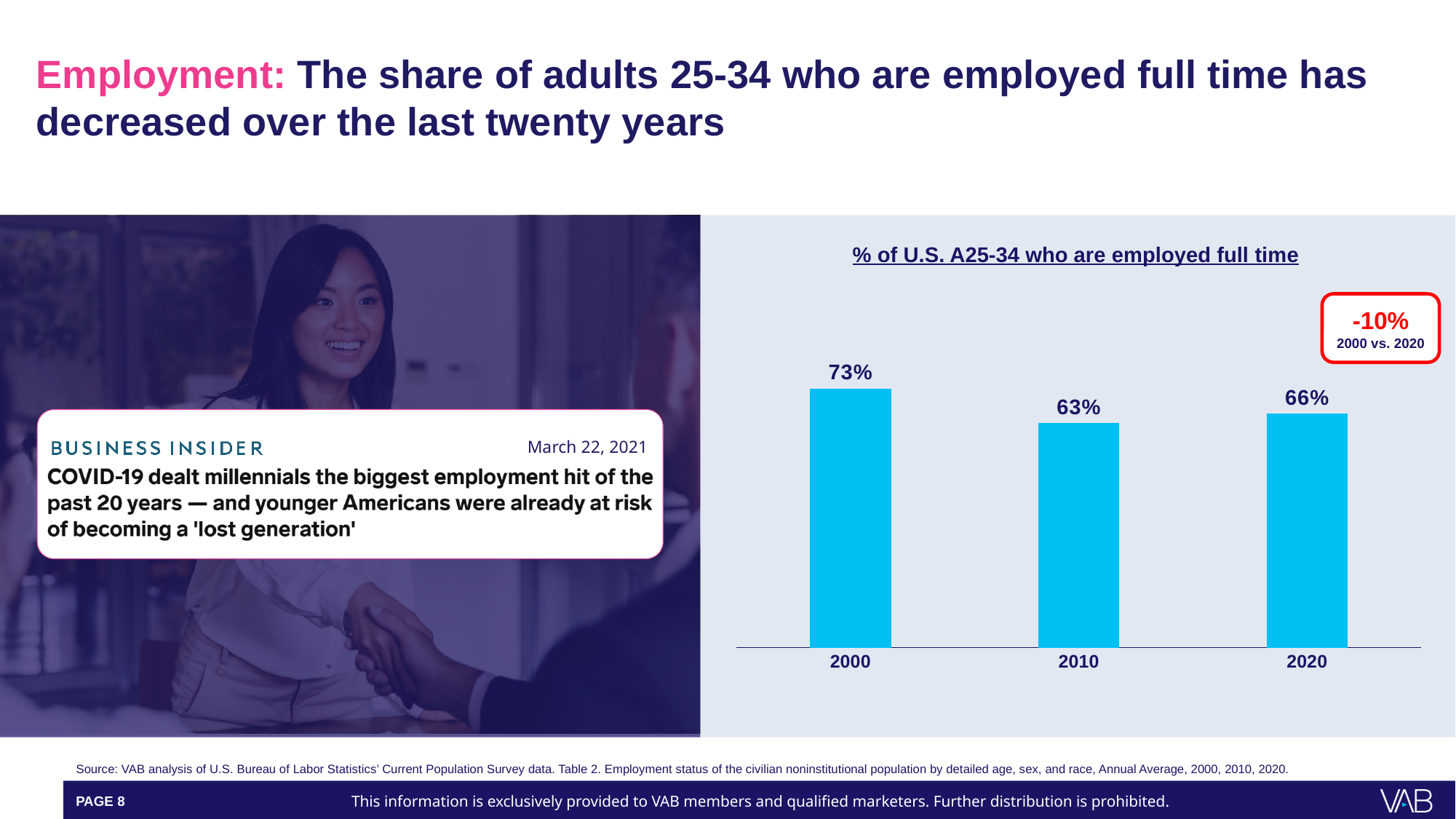
Which year has the highest share of U.S. A25-34 employed full time? 2000 What is the value for 2000? 73% What is the value for 2010? 63% Which year has the lowest share of U.S. A25-34 employed full time? 2010 What is the value for 2020? 66% Which is larger, the value for 2010 or the value for 2020? 2020 What is the title of the chart? % of U.S. A25-34 who are employed full time What change does the red callout box on the chart report for 2000 vs. 2020? -10% What is the difference between the values for 2000 and 2020? 7% How many years are shown on the chart? 3 What is the difference between the values for 2000 and 2010? 10% What kind of chart is shown on the slide? Bar chart